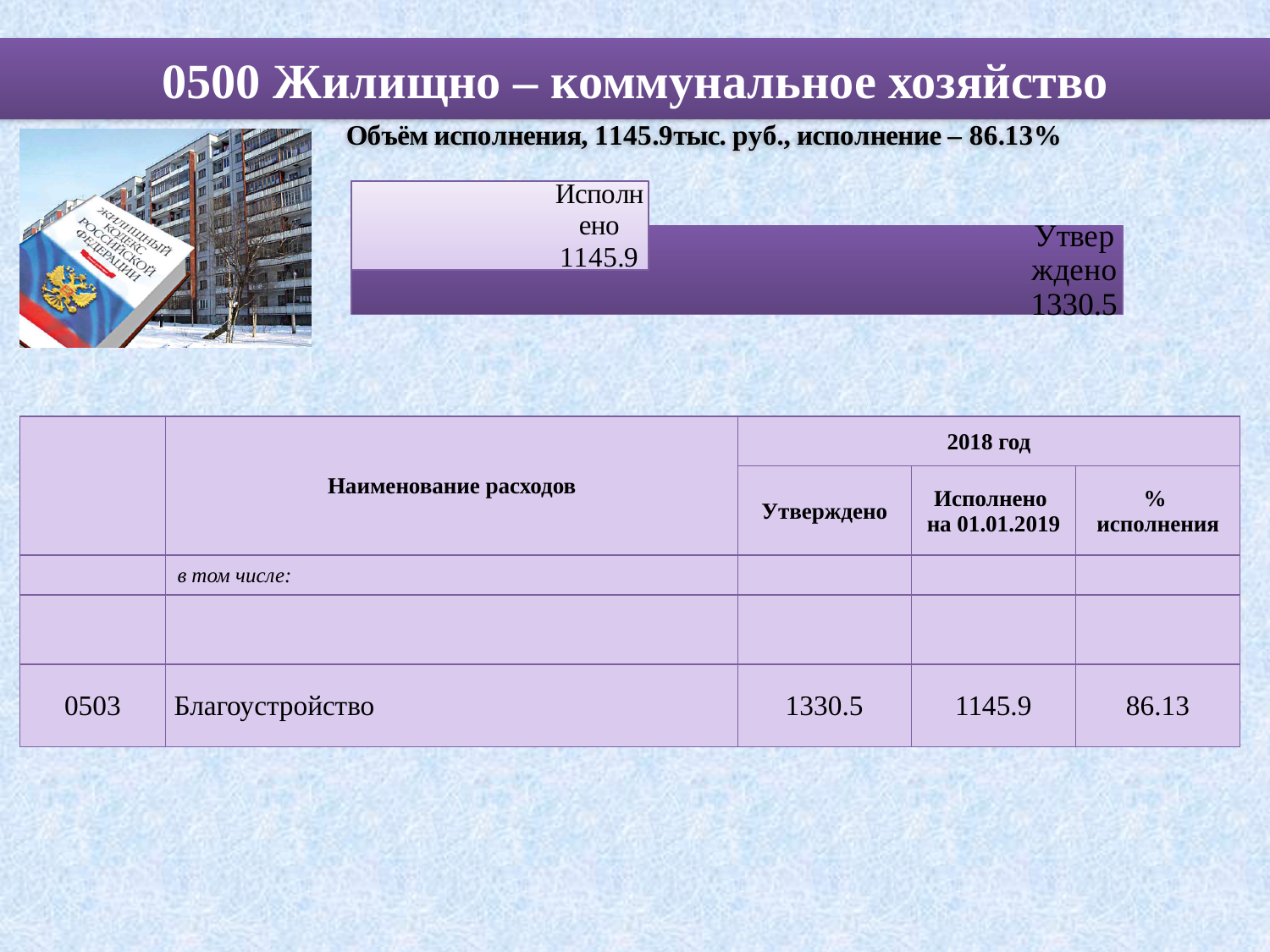
What value is shown for the Исполнено bar in the chart? 1145.9 What kind of chart is shown on the slide? Bar chart Which bar in the chart is drawn in dark purple? Утверждено Are the bars in the chart oriented horizontally or vertically? Horizontally What is the difference between the Утверждено and Исполнено values in the chart? 184.6 How many bars are plotted in the chart? 2 What value is shown for the Утверждено bar in the chart? 1330.5 Which bar in the chart has the highest value? Утверждено Which is larger in the chart, Исполнено or Утверждено? Утверждено Which bar in the chart has the lowest value? Исполнено